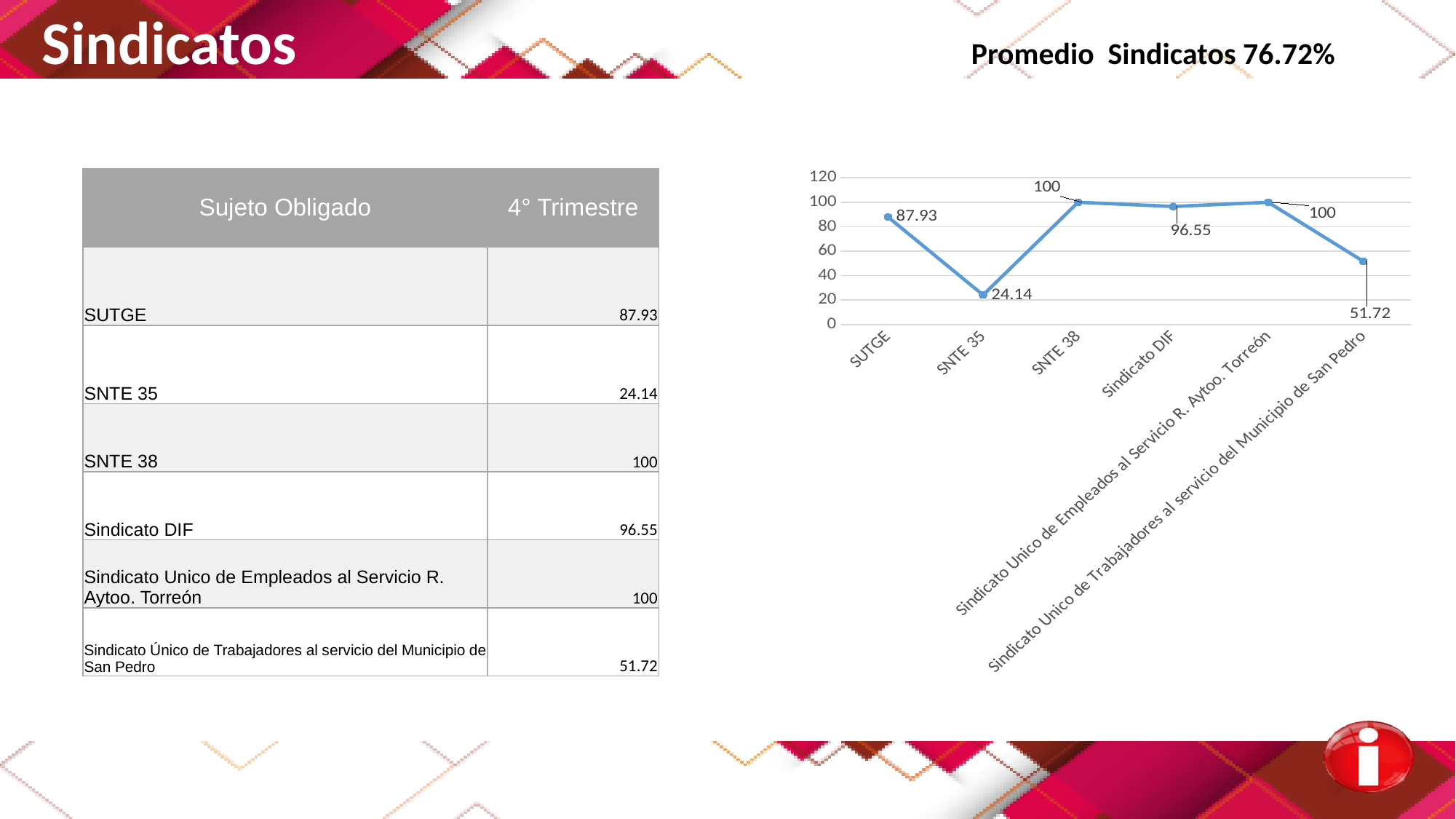
What type of chart is shown on the slide? line chart What is the difference between the values for Sindicato DIF and Sindicato Unico de Trabajadores al servicio del Municipio de San Pedro? 44.83 What is the value for SUTGE in the chart? 87.93 How many categories in the chart have a value of 100? 2 What is the value for SNTE 35 in the chart? 24.14 Does the line rise or fall from SNTE 35 to SNTE 38? rise How many categories are plotted on the x axis of the chart? 6 What is the value for Sindicato DIF in the chart? 96.55 What is the value for Sindicato Unico de Trabajadores al servicio del Municipio de San Pedro in the chart? 51.72 Which is larger, the value for SUTGE or the value for Sindicato DIF? Sindicato DIF Which category has the lowest value in the chart? SNTE 35 What is the difference between the values for SUTGE and SNTE 35? 63.79